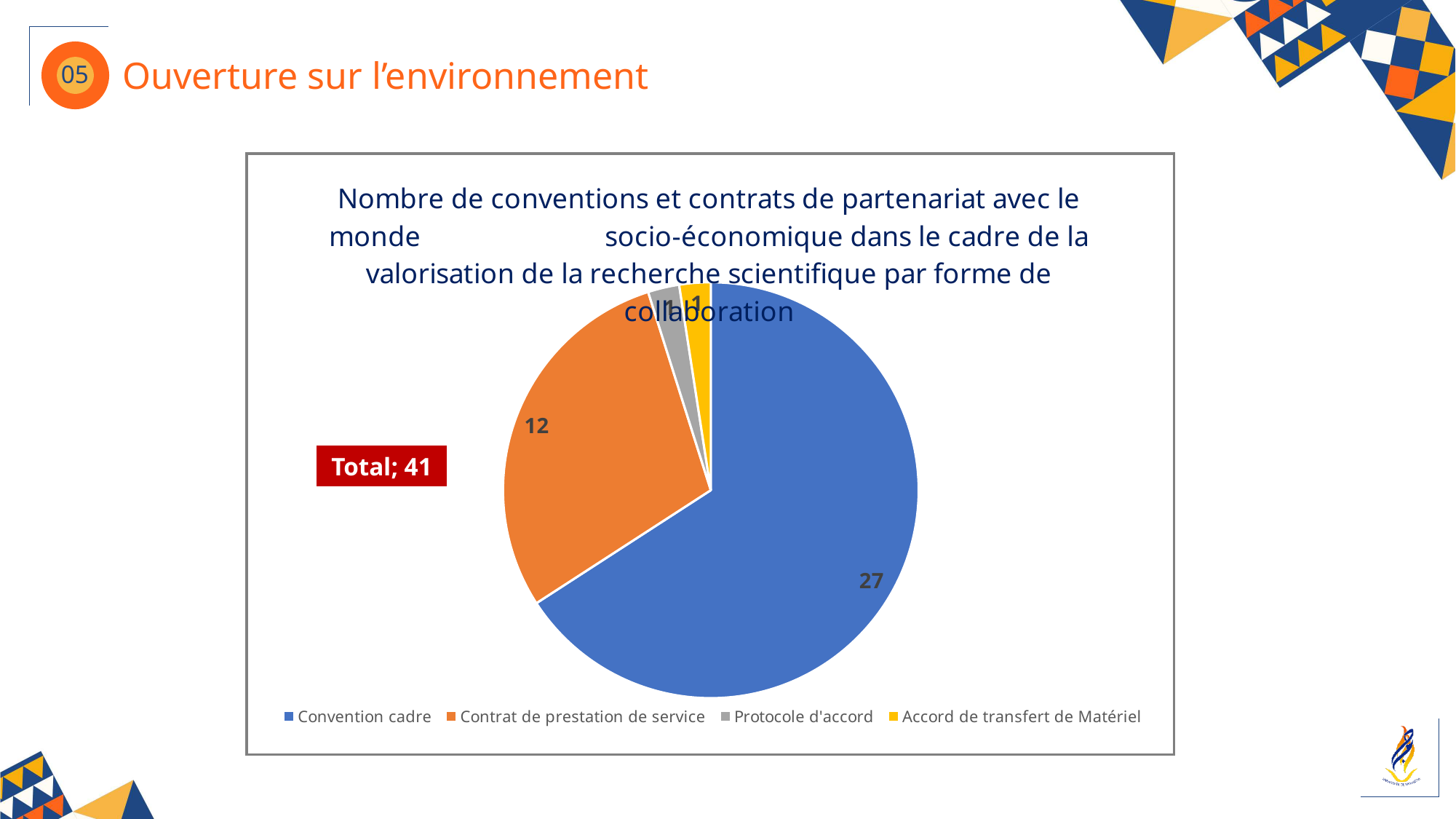
What is the value for Contrat de prestation de service? 12 What is the value for Accord de transfert de Matériel? 1 What colour is the slice for Accord de transfert de Matériel? yellow What type of chart is shown on the slide? pie chart What is the difference between the values for Convention cadre and Contrat de prestation de service? 15 What total is shown in the red box on the chart? Total; 41 What is the value for Protocole d'accord? 1 Which is larger, Contrat de prestation de service or Protocole d'accord? Contrat de prestation de service How many categories does the pie chart show? 4 Which legend entry is shown in orange? Contrat de prestation de service Which category has the largest slice of the pie? Convention cadre What is the value for Convention cadre? 27